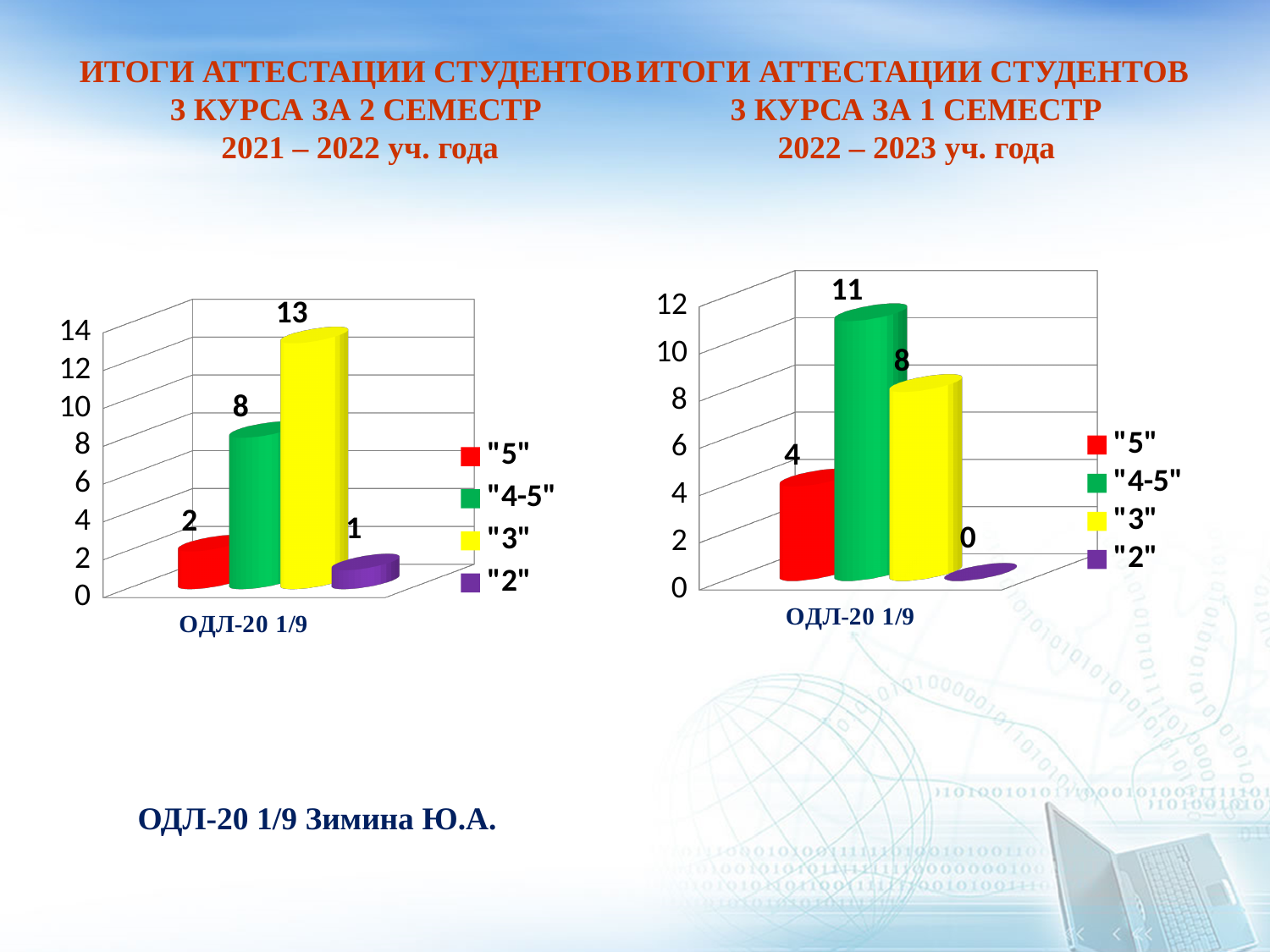
In the right chart (1 семестр 2022 – 2023 уч. года), what is the value for the "4-5" series? 11 In the left chart (2 семестр 2021 – 2022 уч. года), what is the value for the "3" series? 13 In the right chart (1 семестр 2022 – 2023 уч. года), what is the difference between the "4-5" and "5" values? 7 How many series does the legend of the right chart (1 семестр 2022 – 2023 уч. года) list? 4 What colour represents the "4-5" series in the right chart (1 семестр 2022 – 2023 уч. года)? Green In the left chart (2 семестр 2021 – 2022 уч. года), which series has the highest value? "3" In the left chart (2 семестр 2021 – 2022 уч. года), what is the total of all four series values? 24 In the left chart (2 семестр 2021 – 2022 уч. года), which is larger: the "5" value or the "2" value? "5" In the right chart (1 семестр 2022 – 2023 уч. года), which series has the lowest value? "2" In the left chart (2 семестр 2021 – 2022 уч. года), what is the difference between the "3" and "4-5" values? 5 What kind of chart is the left chart (2 семестр 2021 – 2022 уч. года)? Bar chart In the right chart (1 семестр 2022 – 2023 уч. года), what is the value for the "2" series? 0